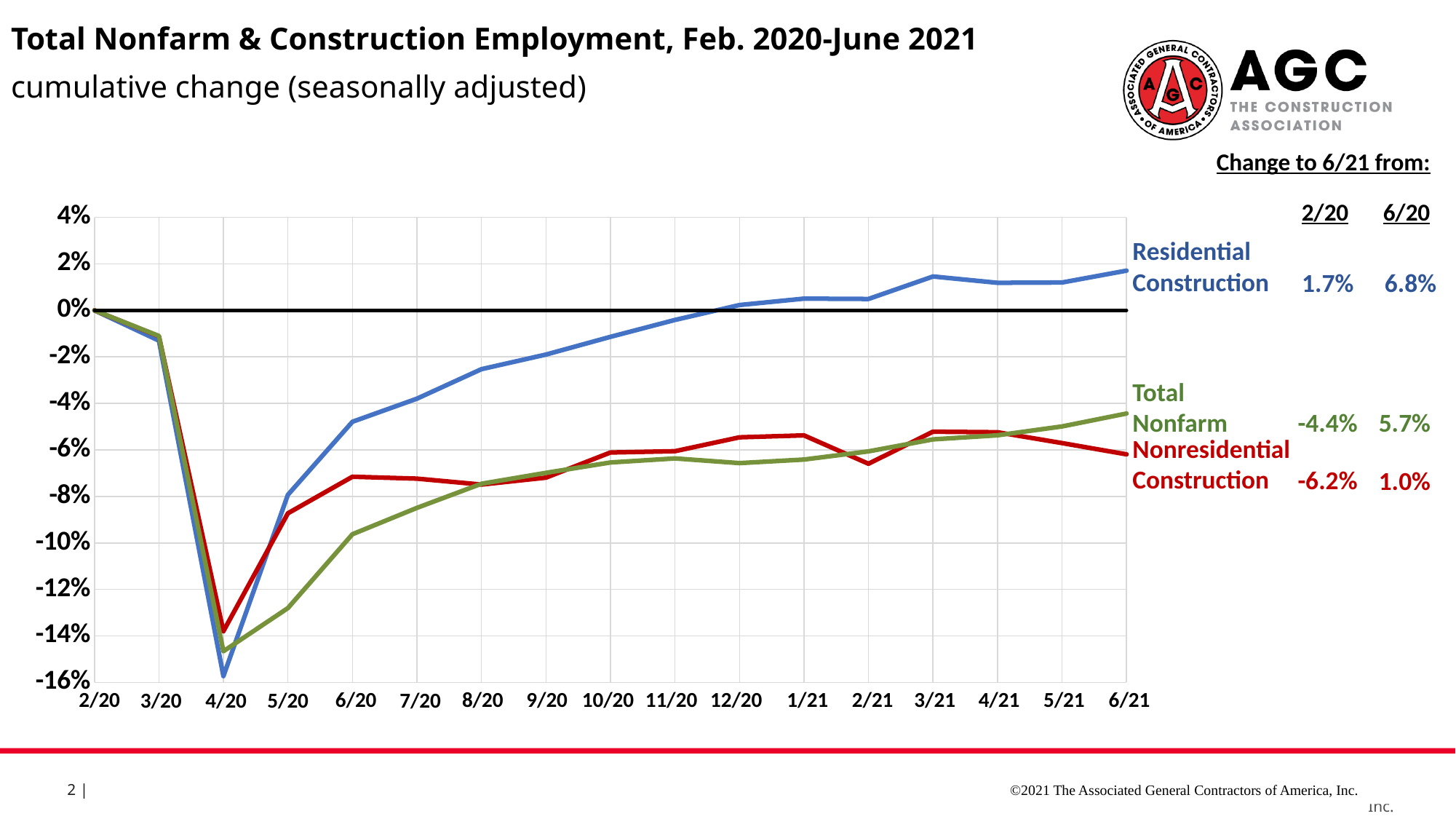
Is the value for Total Nonfarm at 6/20 greater or less than -8%? less How many series are plotted on the chart? 3 What is the difference between the change to 6/21 from 2/20 for Residential Construction (1.7%) and for Nonresidential Construction (-6.2%)? 7.9 percentage points Is the value for Residential Construction at 4/20 greater or less than -14%? less In which month does the Residential Construction line reach its lowest point? 4/20 How many months are shown along the x axis of the chart? 17 What kind of chart is shown on the slide? line chart What is the change to 6/21 from 2/20 for Residential Construction? 1.7% What is the change to 6/21 from 2/20 for Nonresidential Construction? -6.2% What colour is the Total Nonfarm line on the chart? green Which series has the highest value at 6/21? Residential Construction What is the change to 6/21 from 6/20 for Total Nonfarm? 5.7%